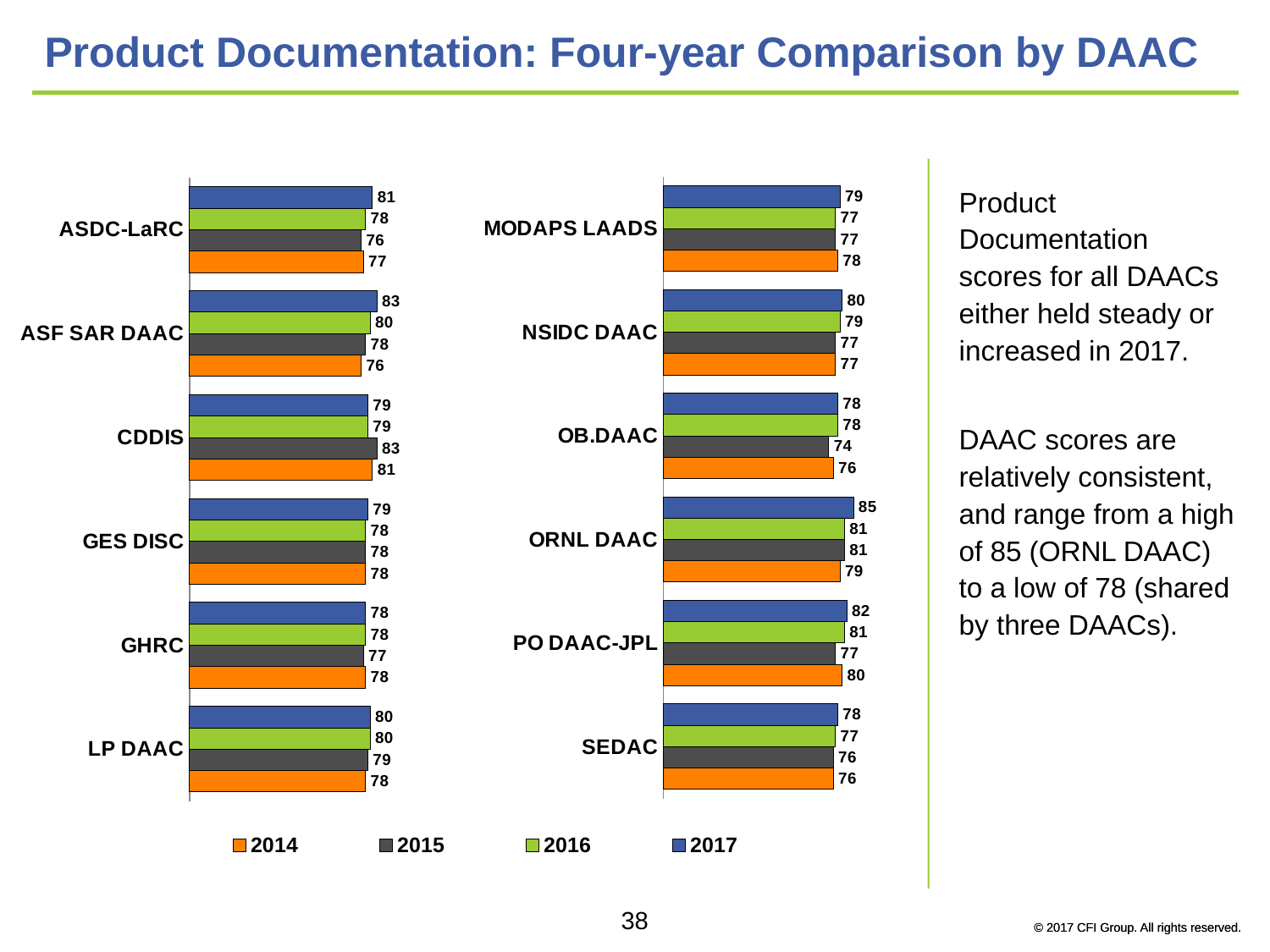
In the right chart, what is the 2015 value for OB.DAAC? 74 In the right chart, which DAAC has the highest 2017 value? ORNL DAAC What kind of chart is shown on the slide? bar chart How many DAACs are shown in the left chart? 6 In the left chart, what is the 2014 value for CDDIS? 81 In the right chart, which is larger for PO DAAC-JPL: the 2014 value or the 2015 value? 2014 How many series does the legend list? 4 In the left chart, which DAAC has the lowest 2014 value? ASF SAR DAAC In the left chart, what is the difference between the 2017 and 2014 values for ASF SAR DAAC? 7 Which colour represents 2017 in the legend? blue In the left chart, what is the 2017 value for ASF SAR DAAC? 83 In the right chart, what is the difference between the 2017 and 2014 values for ORNL DAAC? 6